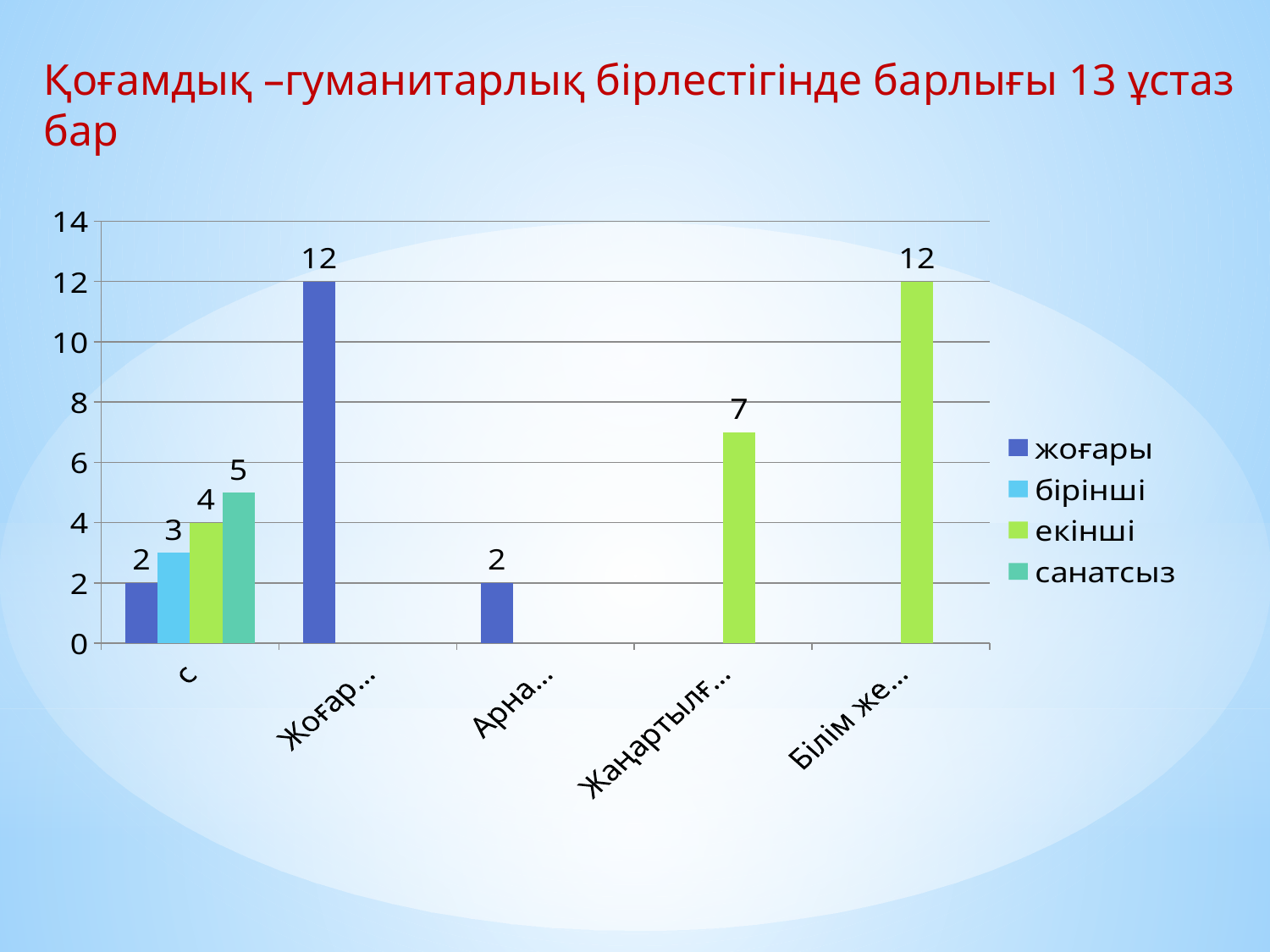
How many categories are shown along the x axis? 5 In the category labelled "с", what is the difference between the санатсыз value and the жоғары value? 3 What is the value of the бірінші series for the category labelled "с"? 3 How many series does the legend list? 4 What are the four entries listed in the legend? жоғары, бірінші, екінші, санатсыз What is the value of the жоғары series for the second category from the left? 12 In the category labelled "с", which series has the lowest value? жоғары What kind of chart is shown on the slide? bar chart Which is larger: the жоғары value in the second category from the left or the жоғары value in the third category from the left? the second category What is the value of the екінші series for the fourth category from the left? 7 What is the value of the санатсыз series for the category labelled "с"? 5 In the category labelled "с", which series has the highest value? санатсыз